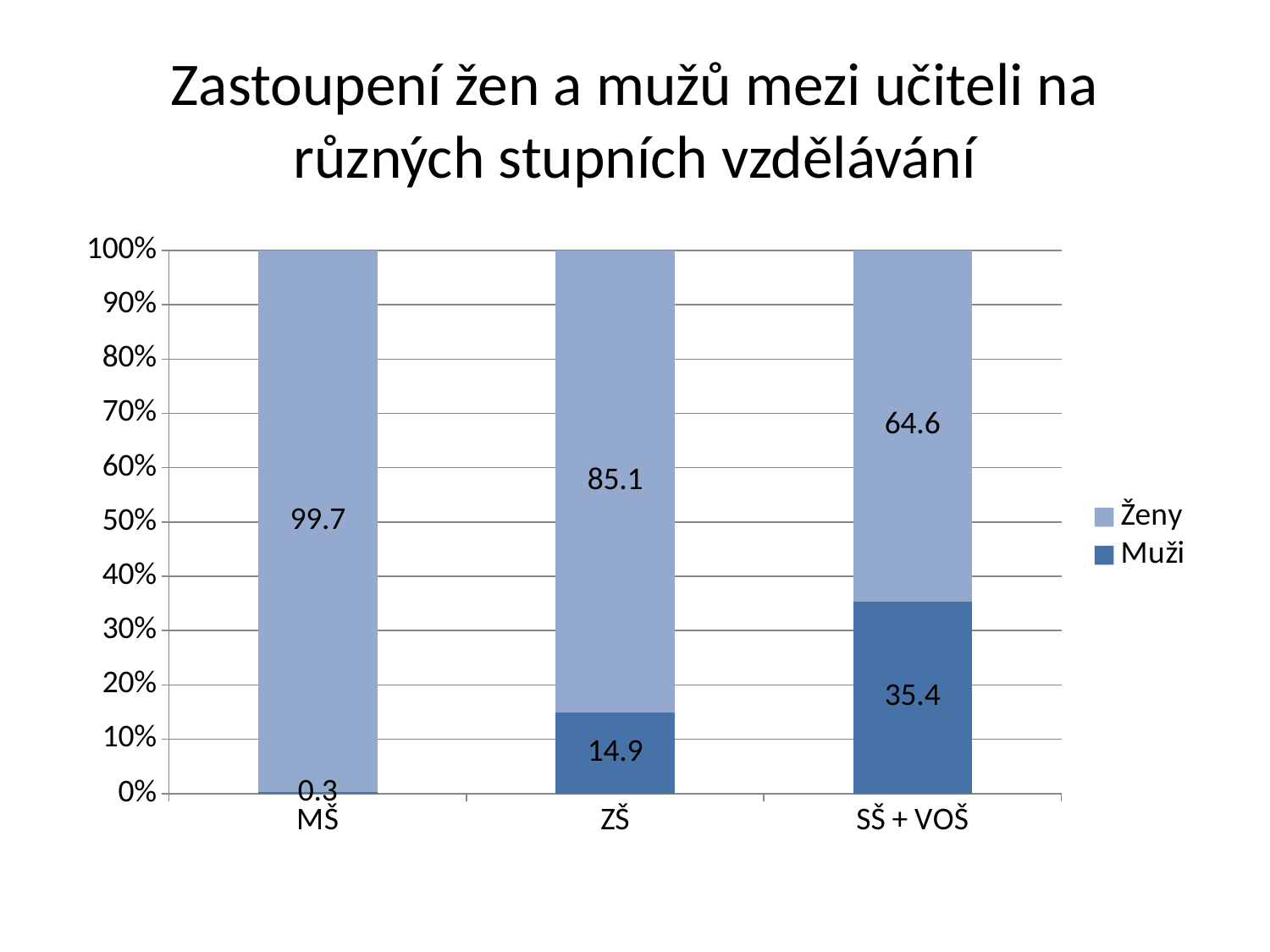
What is the value for Muži in the ZŠ category? 14.9 How many categories are shown on the x axis? 3 Which category has the lowest value for Ženy? SŠ + VOŠ What is the difference between the Ženy values for ZŠ and SŠ + VOŠ? 20.5 What is the value for Ženy in the SŠ + VOŠ category? 64.6 What kind of chart is shown on the slide? Stacked bar chart Which is larger: the Muži value for ZŠ or the Muži value for SŠ + VOŠ? SŠ + VOŠ What is the value for Muži in the SŠ + VOŠ category? 35.4 How many series does the legend list? 2 What is the value for Ženy in the MŠ category? 99.7 Do the Muži values rise or fall from MŠ to SŠ + VOŠ? Rise Which category has the highest value for Muži? SŠ + VOŠ